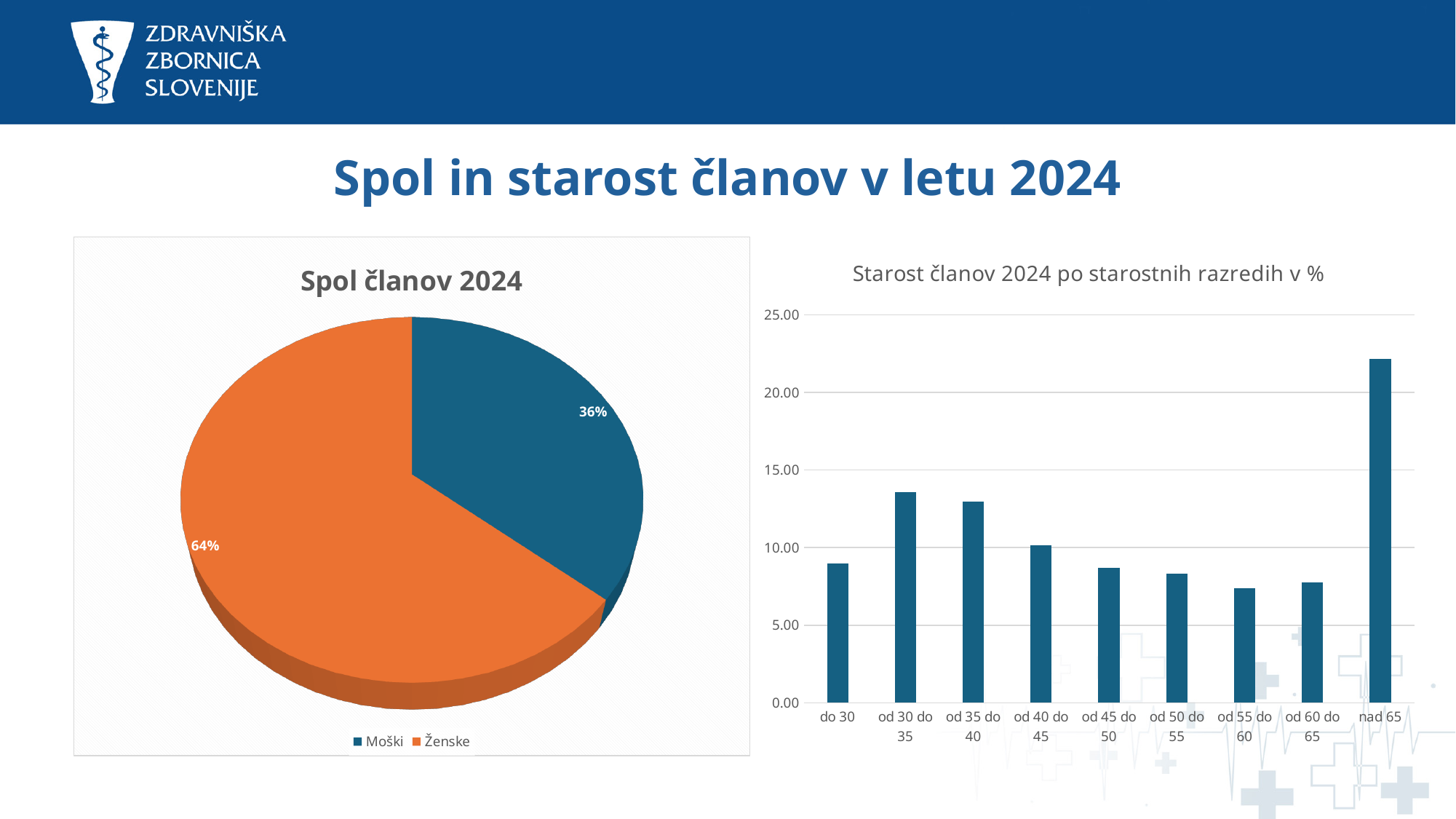
Which colour represents Moški in the pie chart 'Spol članov 2024'? Blue In the pie chart 'Spol članov 2024', which category has the larger share? Ženske How many age categories are shown in the bar chart 'Starost članov 2024 po starostnih razredih v %'? 9 How many entries does the legend of the pie chart 'Spol članov 2024' list? 2 In the pie chart 'Spol članov 2024', by how many percentage points does Ženske exceed Moški? 28 percentage points In the bar chart 'Starost članov 2024 po starostnih razredih v %', which age category has the highest value? nad 65 In the pie chart 'Spol članov 2024', what percentage is shown for Ženske? 64% What kind of chart is 'Starost članov 2024 po starostnih razredih v %'? Bar chart In the bar chart 'Starost članov 2024 po starostnih razredih v %', is the value for 'do 30' greater or less than 10.00? less In the bar chart 'Starost članov 2024 po starostnih razredih v %', which is larger: the value for 'od 30 do 35' or for 'od 45 do 50'? od 30 do 35 In the pie chart 'Spol članov 2024', what percentage is shown for Moški? 36% In the bar chart 'Starost članov 2024 po starostnih razredih v %', is the value for 'nad 65' greater or less than 20.00? greater